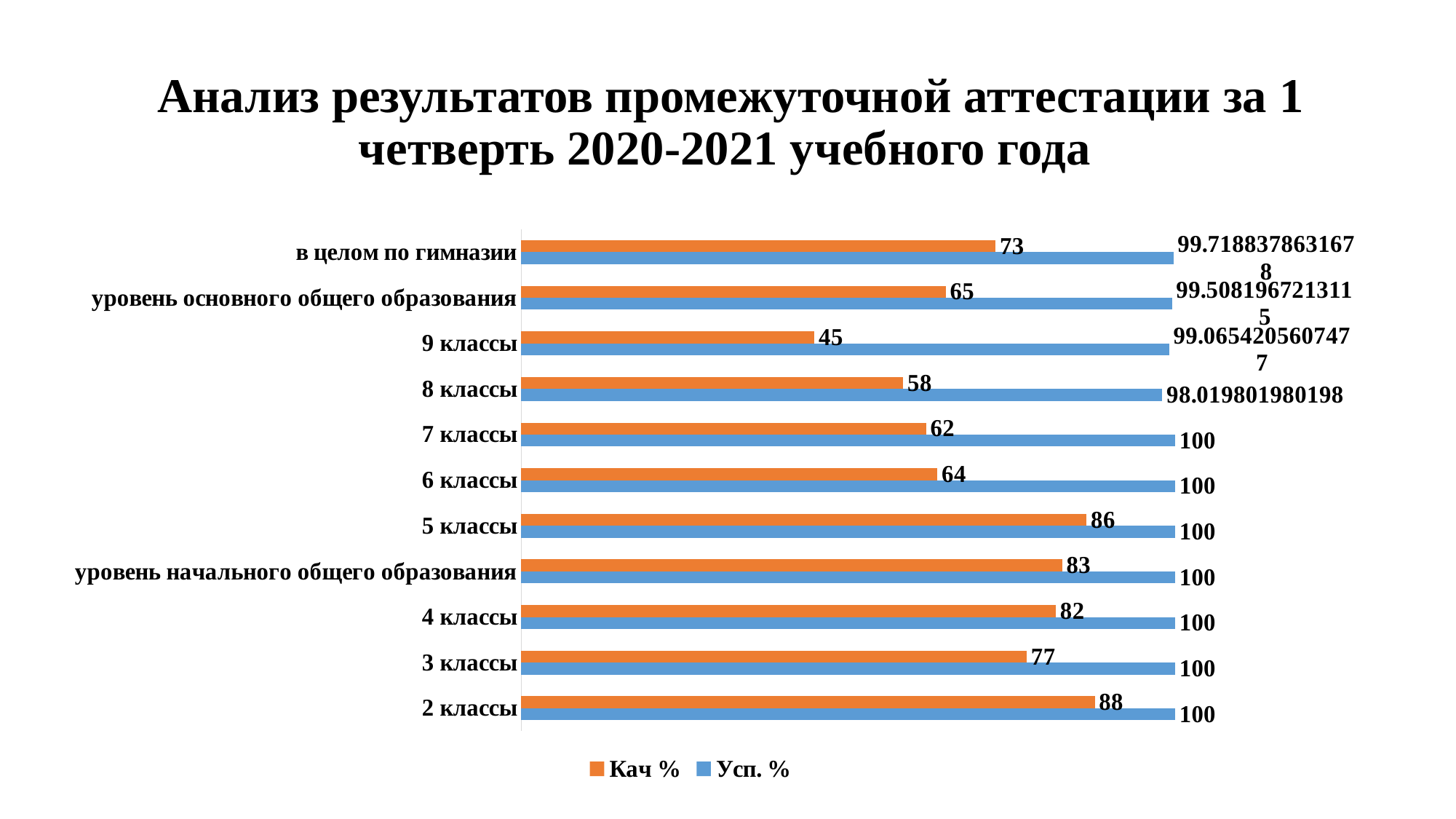
What type of chart is shown on the slide? bar chart How many series does the legend list? 2 Which has a larger Кач % value, 3 классы or 4 классы? 4 классы What is the Кач % value for 9 классы? 45 How many categories are plotted on the chart? 11 Which category has the lowest Кач % value? 9 классы What is the Усп. % value for 8 классы? 98.019801980198 What is the Кач % value for 2 классы? 88 What is the Кач % value for в целом по гимназии? 73 Which series is shown in orange? Кач % Which category has the highest Кач % value? 2 классы What is the difference between the Кач % values for 5 классы and 6 классы? 22